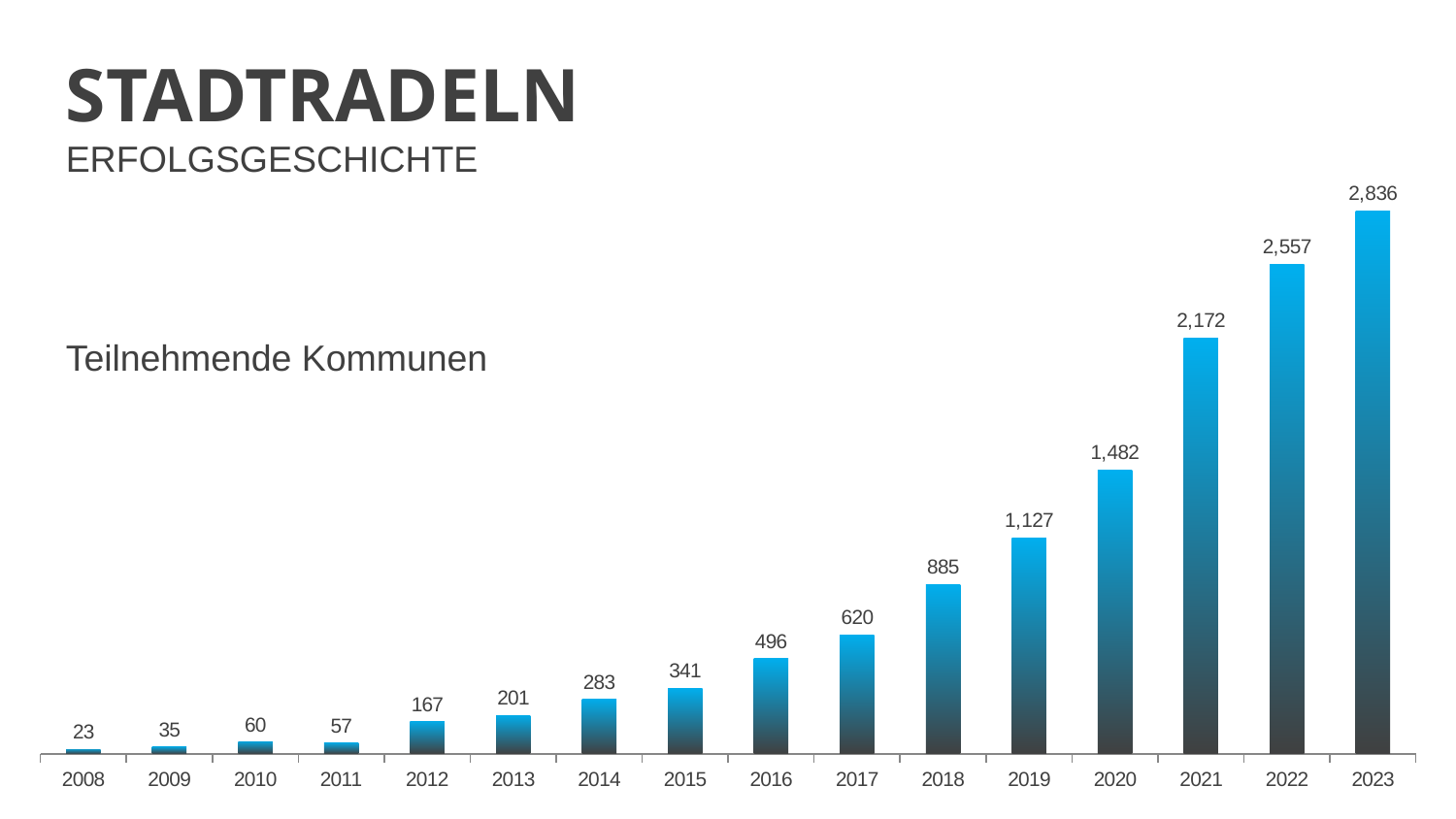
What is the difference between the values for 2023 and 2022? 279 What is the value for 2016? 496 What does the chart show, according to the label on the slide? Teilnehmende Kommunen Which year has the highest value? 2023 Do the values generally rise or fall from 2008 to 2023? rise What kind of chart is shown on the slide? bar chart Which is larger, the value for 2010 or the value for 2011? 2010 What is the difference between the values for 2020 and 2019? 355 How many years are shown on the x axis? 16 Which year has the lowest value? 2008 What is the value for 2008? 23 What is the value for 2021? 2,172